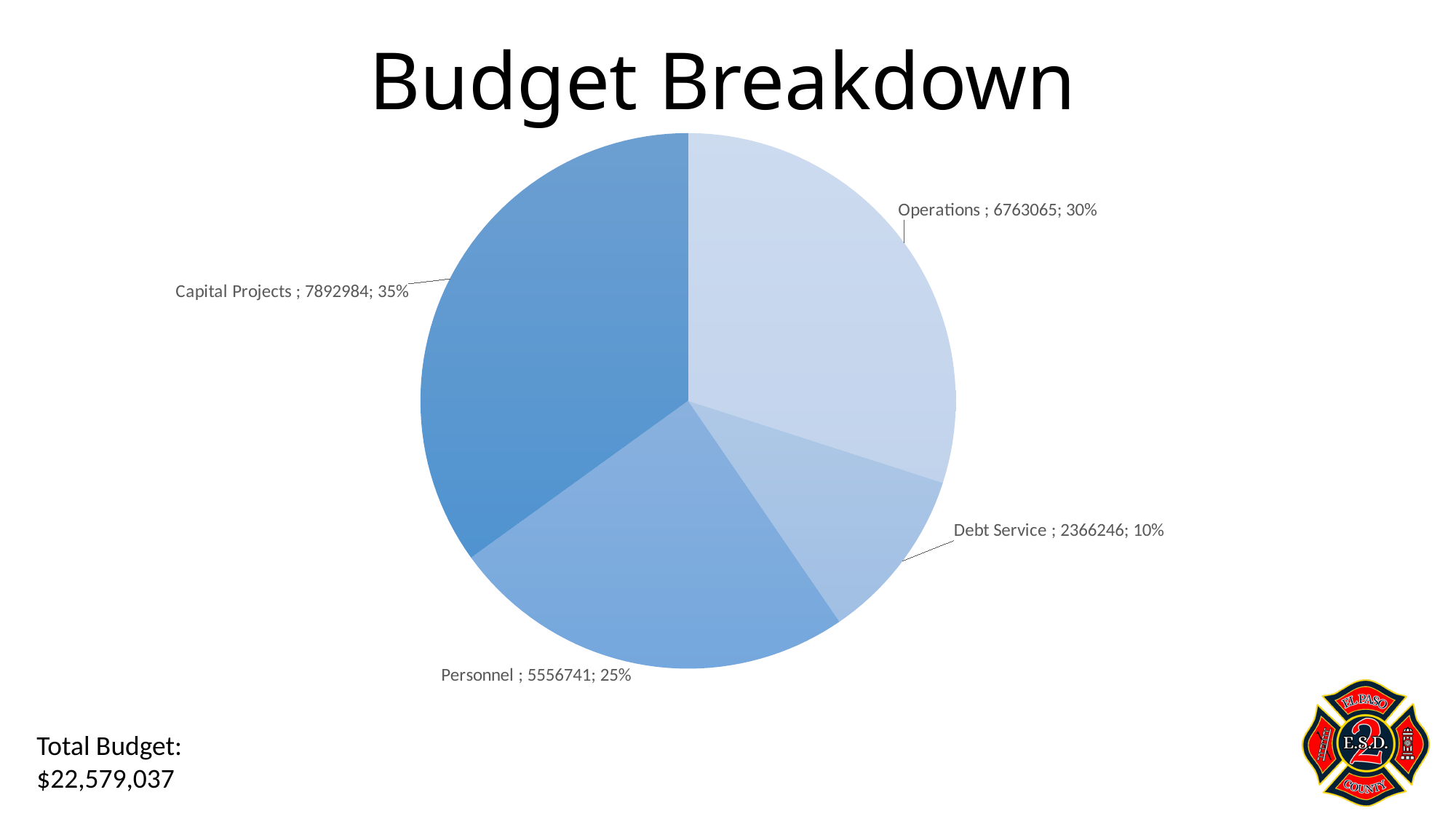
What share of the pie does Personnel represent? 25% What is the value for Capital Projects? 7892984 What share of the pie does Operations represent? 30% Which category has the largest slice of the pie? Capital Projects What is the value for Personnel? 5556741 Which is larger, the value for Personnel or the value for Debt Service? Personnel What kind of chart is shown on the slide? pie chart How many categories are shown in the pie chart? 4 What is the difference between the Capital Projects value and the Operations value? 1129919 What is the value for Operations? 6763065 What is the value for Debt Service? 2366246 Which category has the smallest slice of the pie? Debt Service